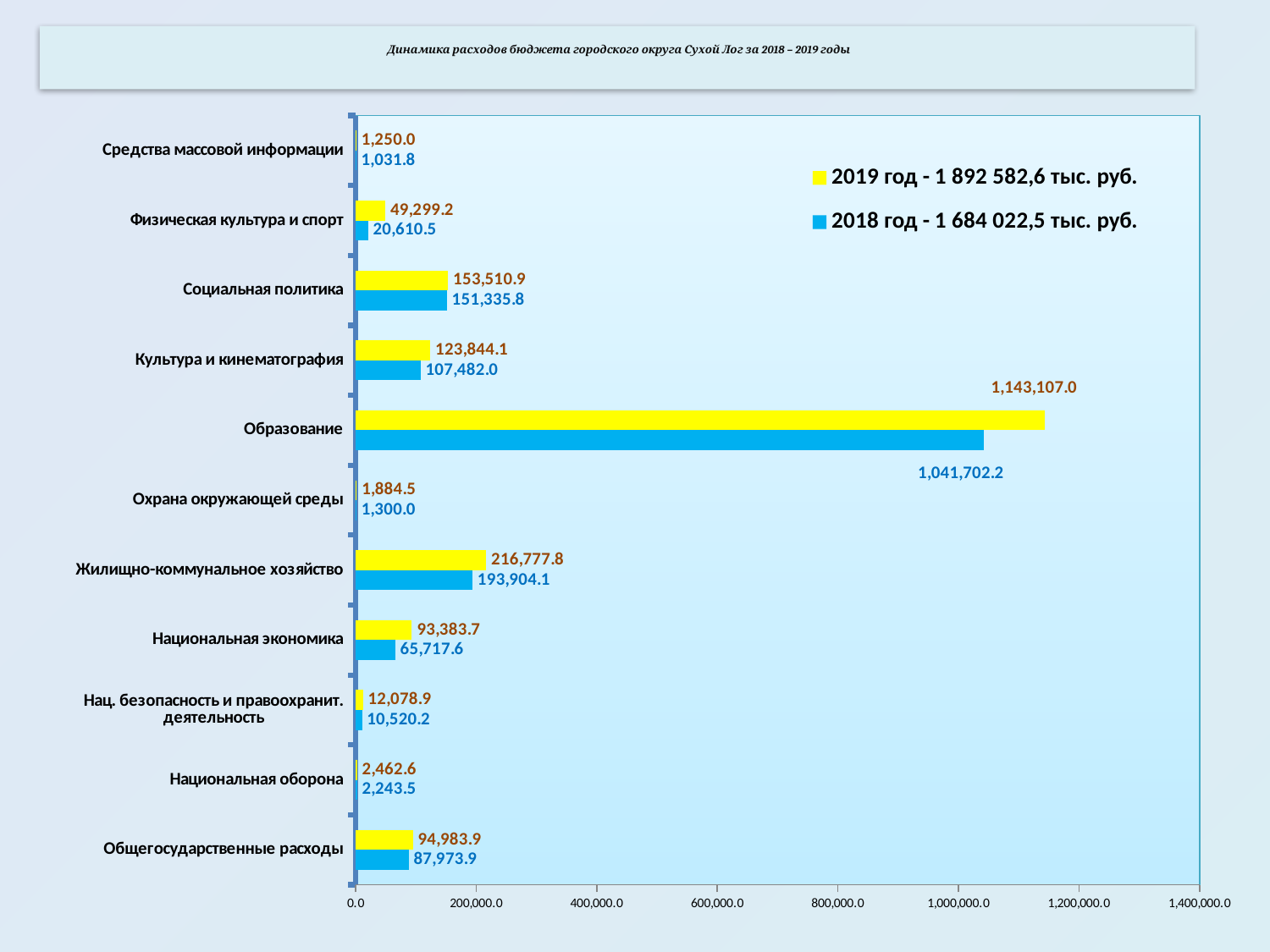
What is the 2019 value for Физическая культура и спорт? 49,299.2 What is the 2019 value for Образование? 1,143,107.0 What kind of chart is shown on the slide? Bar chart What is the difference between the 2019 and 2018 values for Образование? 101,404.8 What is the 2018 value for Общегосударственные расходы? 87,973.9 What is the 2018 value for Жилищно-коммунальное хозяйство? 193,904.1 Which category has the highest 2019 value? Образование How many categories are shown on the chart? 11 What is the difference between the 2019 and 2018 values for Национальная экономика? 27,666.1 Which is larger: the 2019 value for Жилищно-коммунальное хозяйство or the 2019 value for Социальная политика? Жилищно-коммунальное хозяйство How many series does the legend list? 2 Which category has the lowest 2018 value? Средства массовой информации